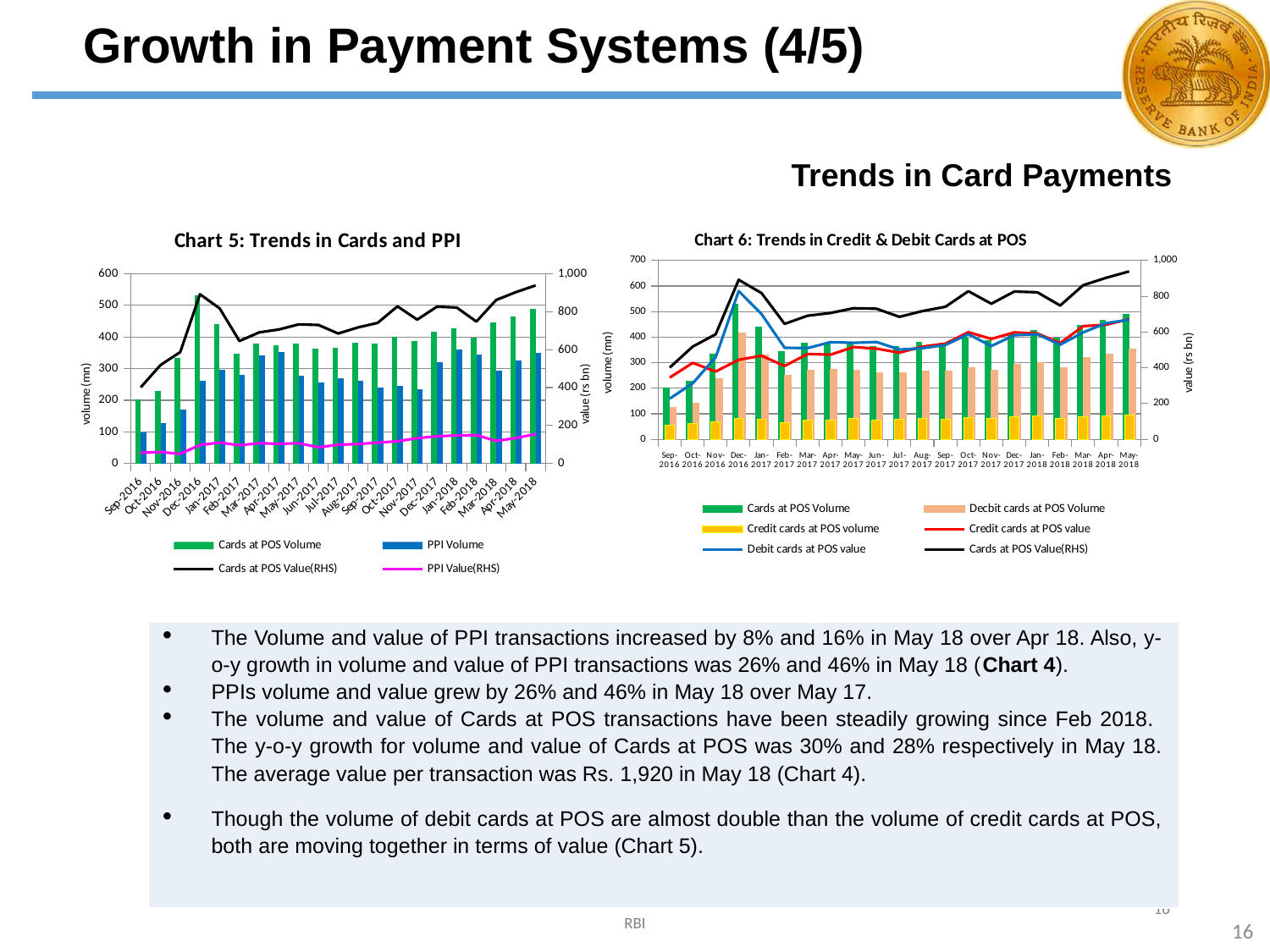
In Chart 5: Trends in Cards and PPI, is the Cards at POS Volume for Dec-2016 greater or less than 500? greater In Chart 6: Trends in Credit & Debit Cards at POS, which is larger in May-2018, Debit cards at POS Volume or Credit cards at POS volume? Debit cards at POS Volume In Chart 5: Trends in Cards and PPI, how many series does the legend list? 4 In Chart 5: Trends in Cards and PPI, in which month is Cards at POS Volume highest? Dec-2016 In Chart 5: Trends in Cards and PPI, in which month is Cards at POS Value(RHS) highest? May-2018 In Chart 5: Trends in Cards and PPI, how many months are shown on the x axis? 21 In Chart 5: Trends in Cards and PPI, is the PPI Volume for Sep-2016 greater or less than 200? less In Chart 6: Trends in Credit & Debit Cards at POS, is the Cards at POS Value(RHS) for May-2018 greater or less than 800? greater In Chart 6: Trends in Credit & Debit Cards at POS, how many series does the legend list? 6 In Chart 6: Trends in Credit & Debit Cards at POS, in which month is Cards at POS Volume highest? Dec-2016 In Chart 5: Trends in Cards and PPI, what kind of chart is it? A combined bar and line chart